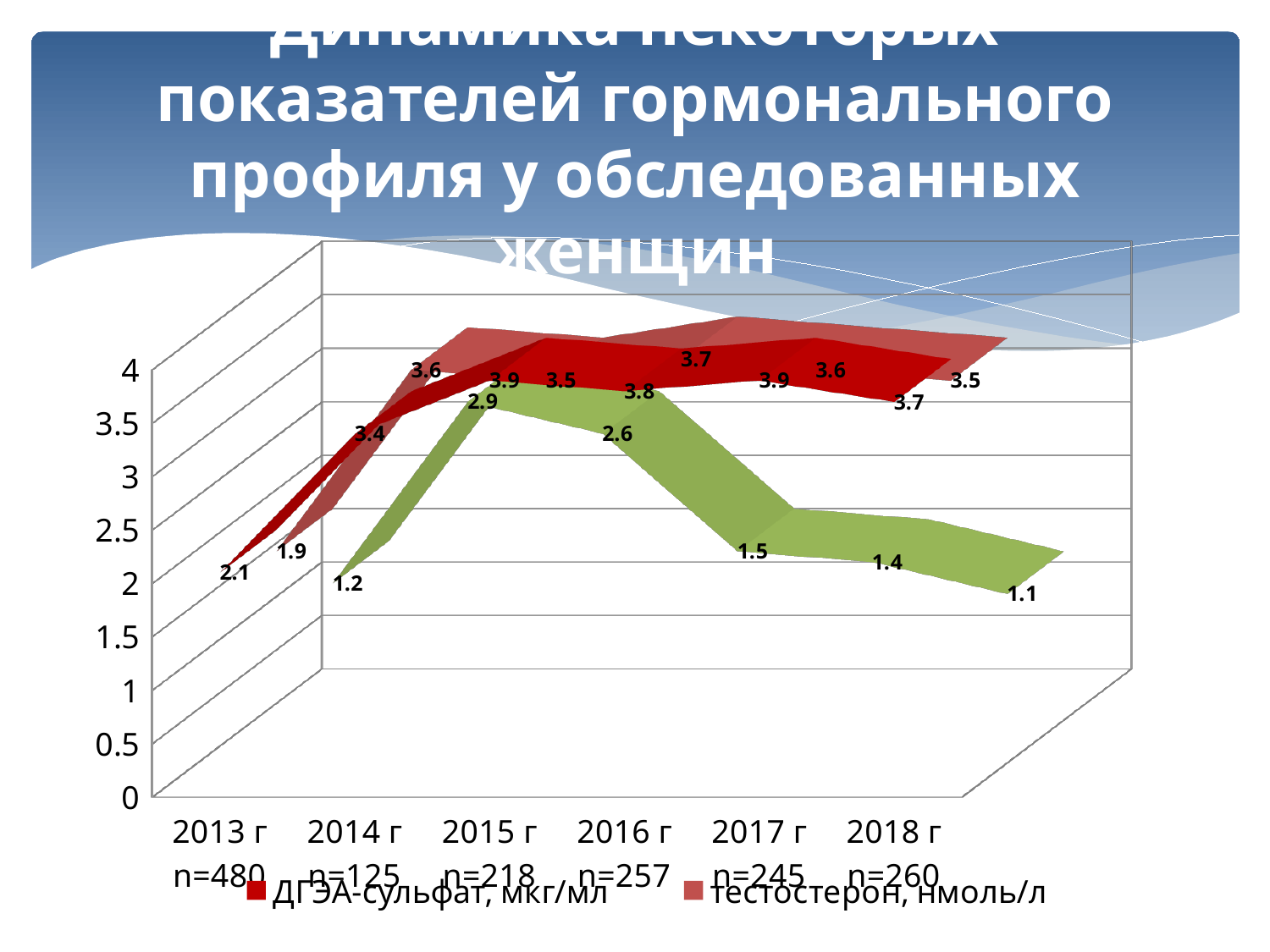
What is the value of ДГЭА-сульфат in 2013 г? 2.1 Does ДГЭА-сульфат rise or fall from 2013 г to 2015 г? rise How many series does the visible legend list? 2 How many years are shown on the x axis of the chart? 6 What kind of chart is shown on the slide? line chart What is the sample size (n) shown for 2013 г? n=480 In which year is тестостерон at its lowest? 2013 г By how much did ДГЭА-сульфат increase from 2013 г to 2014 г? 1.3 What is the value of тестостерон in 2016 г? 3.7 In 2013 г, which is larger: ДГЭА-сульфат or тестостерон? ДГЭА-сульфат What is the value of ДГЭА-сульфат in 2018 г? 3.7 What is the value of тестостерон in 2013 г? 1.9